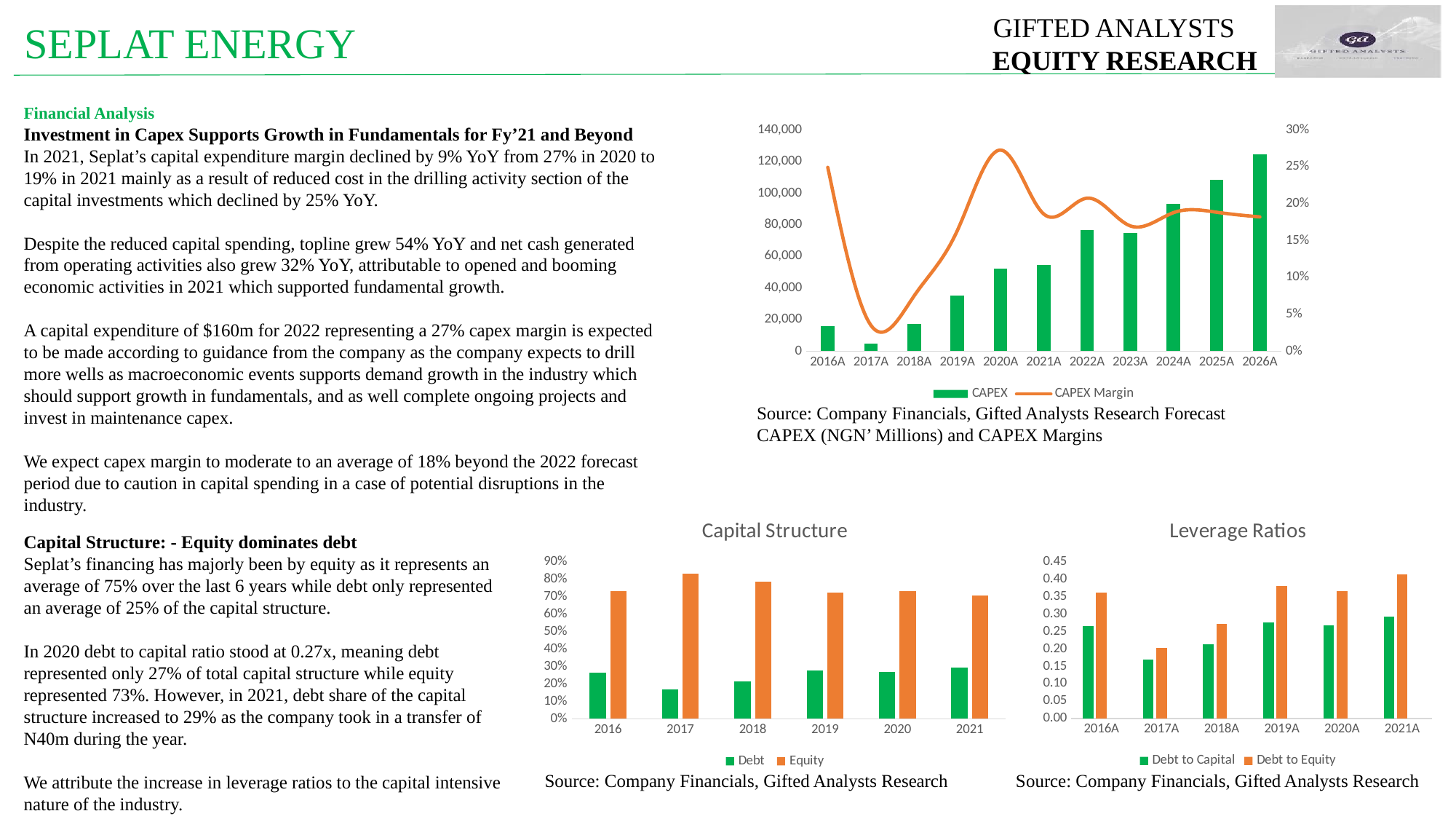
In the Leverage Ratios chart, which year has the highest Debt to Equity bar? 2021A In the Capital Structure chart, which year has the lowest Debt bar? 2017 In the CAPEX (NGN' Millions) and CAPEX Margins chart, which year has the lowest CAPEX bar? 2017A In the Capital Structure chart, is the Debt value for 2021 greater or less than 20%? greater In the Capital Structure chart, which year has the highest Equity bar? 2017 How many years are shown on the x axis of the CAPEX (NGN' Millions) and CAPEX Margins chart? 11 In the CAPEX (NGN' Millions) and CAPEX Margins chart, in which year does the CAPEX Margin line reach its peak? 2020A In the CAPEX (NGN' Millions) and CAPEX Margins chart, is the CAPEX value for 2026A greater or less than 100,000? greater In the Leverage Ratios chart, is the Debt to Capital value for 2017A greater or less than 0.20? less How many series does the legend of the CAPEX (NGN' Millions) and CAPEX Margins chart list? 2 What kind of chart is the Leverage Ratios chart? bar chart